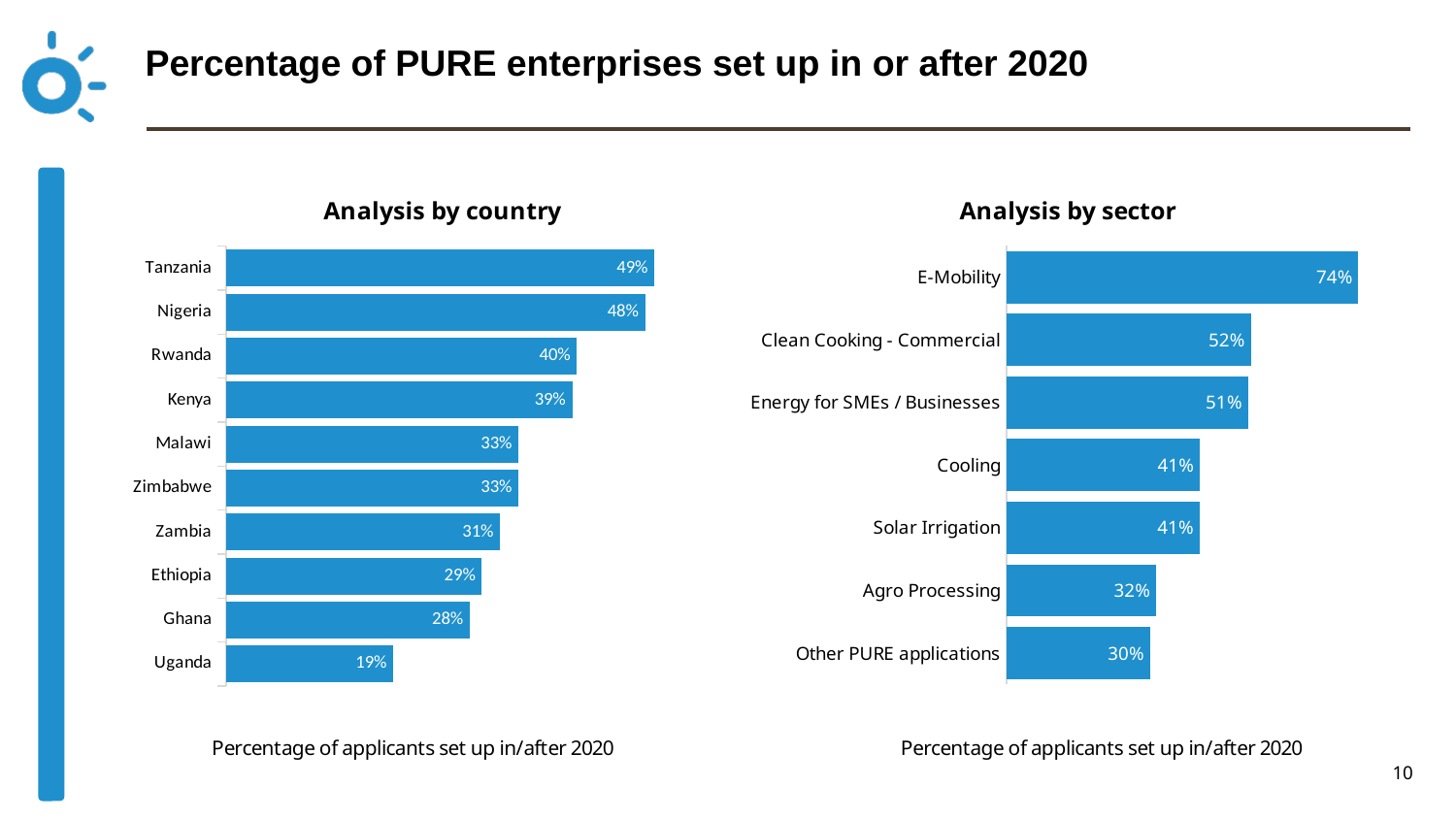
In the 'Analysis by sector' chart, what is the value for Clean Cooking - Commercial? 52% What kind of chart is the 'Analysis by sector' chart? Bar chart In the 'Analysis by sector' chart, what is the difference between the values for E-Mobility and Energy for SMEs / Businesses? 23% In the 'Analysis by sector' chart, what is the value for Agro Processing? 32% In the 'Analysis by country' chart, what is the difference between the values for Tanzania and Uganda? 30% In the 'Analysis by country' chart, which country has the lowest value? Uganda In the 'Analysis by country' chart, how many countries are shown? 10 In the 'Analysis by country' chart, what is the value for Uganda? 19% In the 'Analysis by country' chart, what is the value for Rwanda? 40% In the 'Analysis by sector' chart, which sector has the highest value? E-Mobility In the 'Analysis by sector' chart, which is larger, the value for Cooling or the value for Other PURE applications? Cooling In the 'Analysis by country' chart, which country has the highest value? Tanzania